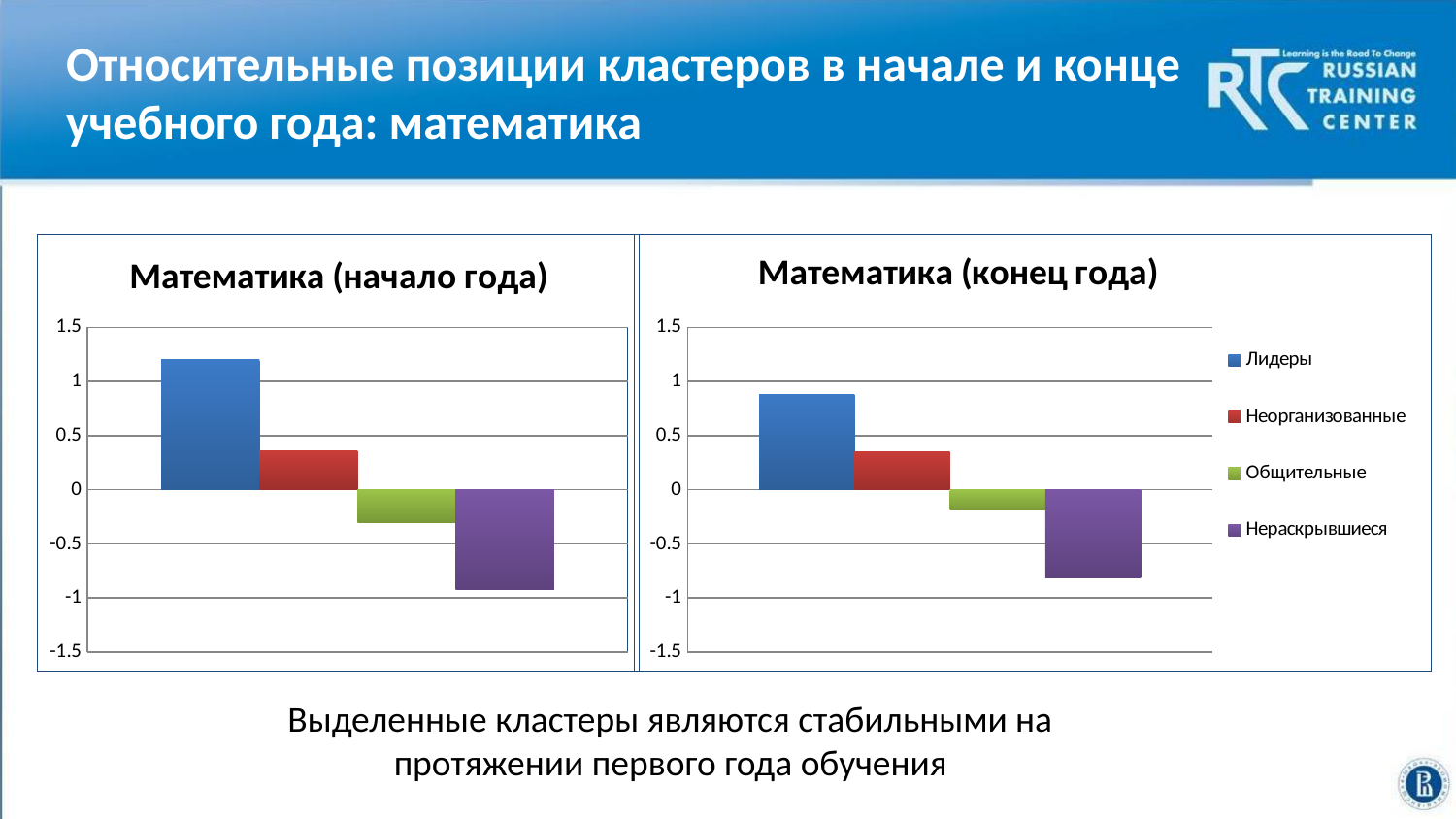
In the "Математика (начало года)" chart, is the value for Лидеры greater or less than 1? greater What kind of chart is "Математика (начало года)"? bar chart In the "Математика (конец года)" chart, is the value for Общительные greater or less than -0.5? greater In the "Математика (начало года)" chart, is the value for Нераскрывшиеся greater or less than -0.5? less In the "Математика (начало года)" chart, which is larger: the value for Лидеры or the value for Неорганизованные? Лидеры How many series does the legend list for the "Математика (конец года)" chart? 4 In the "Математика (начало года)" chart, which cluster has the highest value? Лидеры Which colour represents the Общительные cluster in the legend? green In the "Математика (конец года)" chart, which cluster has the lowest value? Нераскрывшиеся How many bars are plotted in the "Математика (конец года)" chart? 4